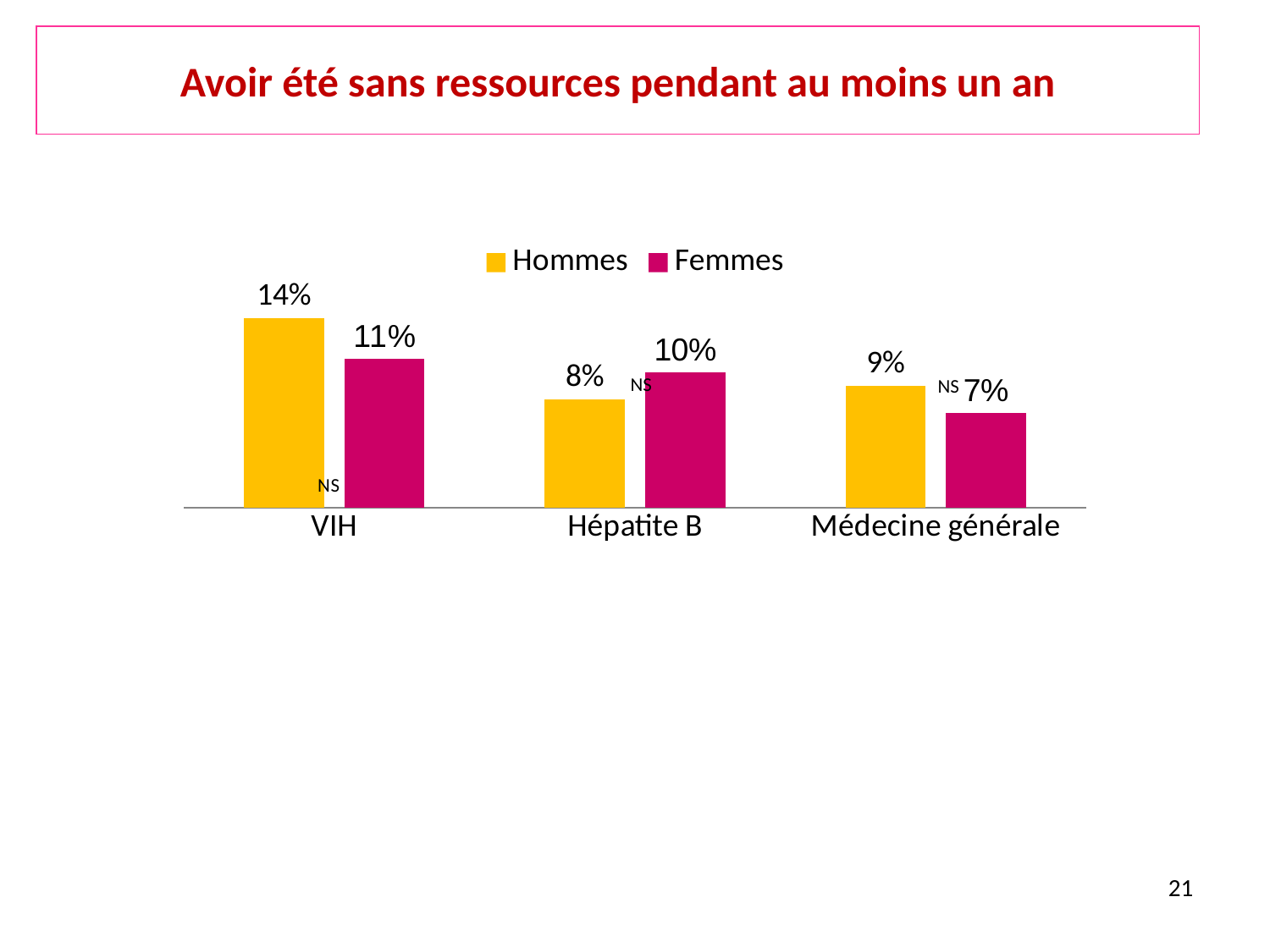
What is the value for Hommes in the Médecine générale category? 9% What is the value for Hommes in the VIH category? 14% In the Hépatite B category, which series has the larger value, Hommes or Femmes? Femmes What kind of chart is shown on the slide? Bar chart What colour are the bars for the Femmes series? Magenta How many categories are shown on the x axis? 3 What is the value for Femmes in the Médecine générale category? 7% What is the value for Femmes in the Hépatite B category? 10% What is the difference between the Hommes and Femmes values in the VIH category? 3% Which category has the lowest value for Femmes? Médecine générale Which category has the highest value for Hommes? VIH How many series does the legend list? 2